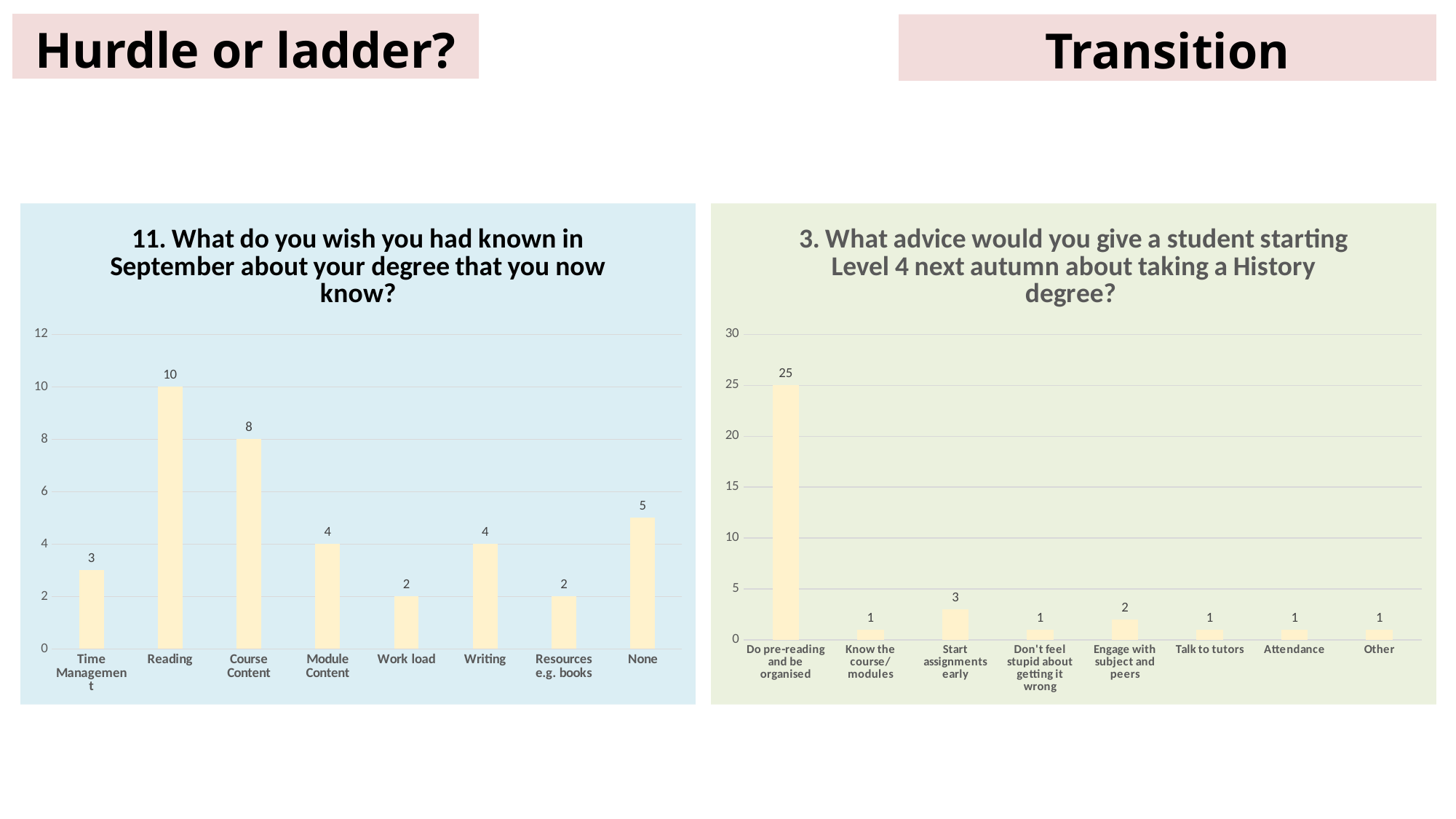
In the right chart ('3. What advice would you give a student starting Level 4...'), what is the value for 'Do pre-reading and be organised'? 25 In the left chart ('11. What do you wish you had known in September...'), what is the value for Course Content? 8 What type of chart is the right chart ('3. What advice would you give a student starting Level 4...')? Bar chart In the left chart ('11. What do you wish you had known in September...'), what is the value for Reading? 10 In the left chart ('11. What do you wish you had known in September...'), what is the difference between the values for Reading and None? 5 In the right chart ('3. What advice would you give a student starting Level 4...'), which category has the highest value? Do pre-reading and be organised In the left chart ('11. What do you wish you had known in September...'), which is larger, Time Management or Module Content? Module Content In the right chart ('3. What advice would you give a student starting Level 4...'), what is the value for 'Start assignments early'? 3 In the left chart ('11. What do you wish you had known in September...'), which category has the highest value? Reading In the right chart ('3. What advice would you give a student starting Level 4...'), what is the difference between 'Do pre-reading and be organised' and 'Engage with subject and peers'? 23 In the left chart ('11. What do you wish you had known in September...'), how many categories are shown on the x axis? 8 In the right chart ('3. What advice would you give a student starting Level 4...'), how many categories are shown on the x axis? 8